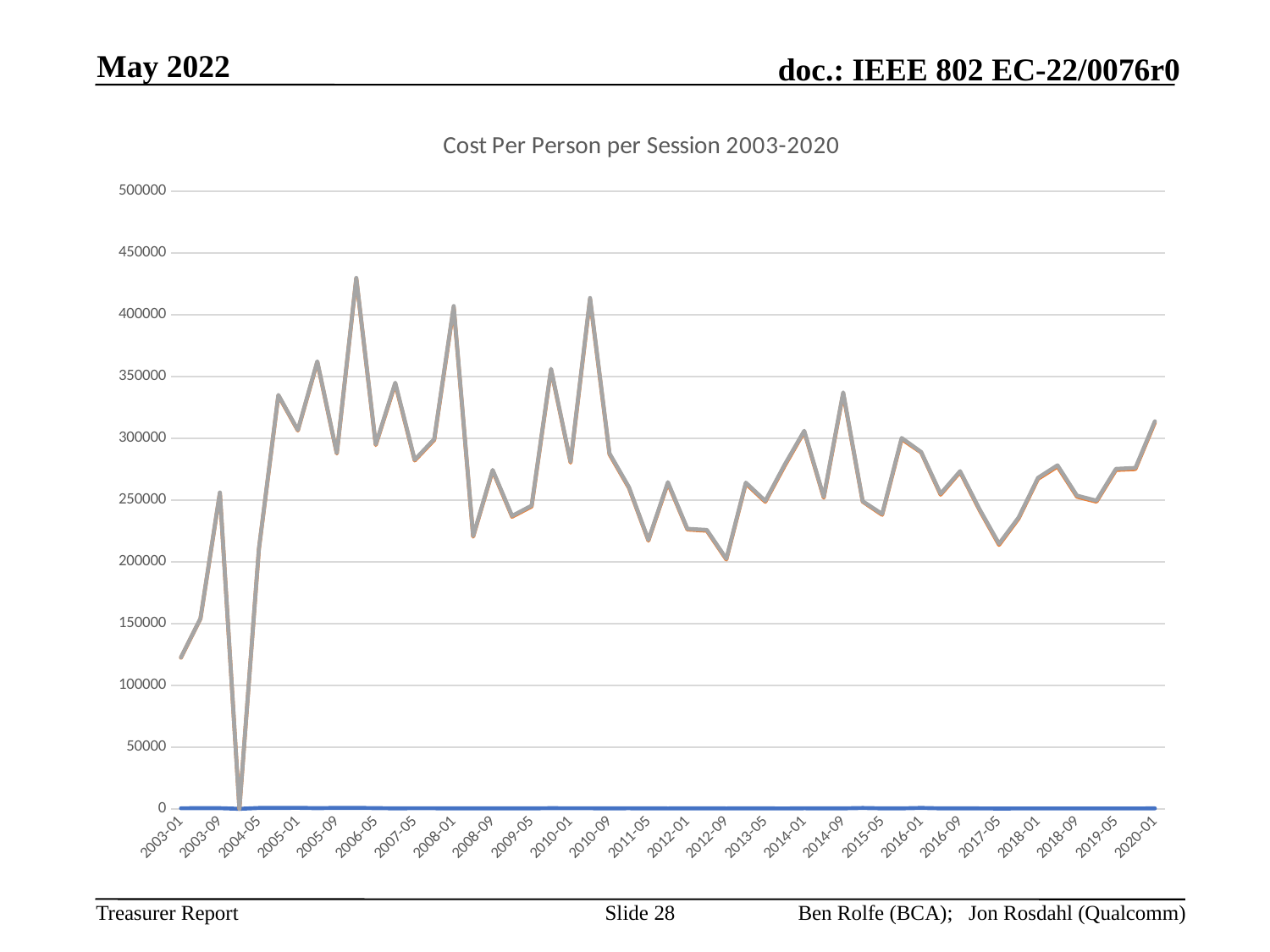
Is the value for 2003-01 greater or less than 100000? greater What is the highest value shown on the vertical axis? 500000 Is the highest peak of the gray line greater or less than 400000? greater Which is larger, the value at 2003-01 or the value at 2003-09? 2003-09 Is the value for 2003-01 greater or less than 150000? less Between 2003-01 and 2003-09, does the gray line rise or fall? rise What kind of chart is shown on the slide? Line chart Which is larger, the value at 2003-01 or the value at 2020-01? 2020-01 What is the title of the chart? Cost Per Person per Session 2003-2020